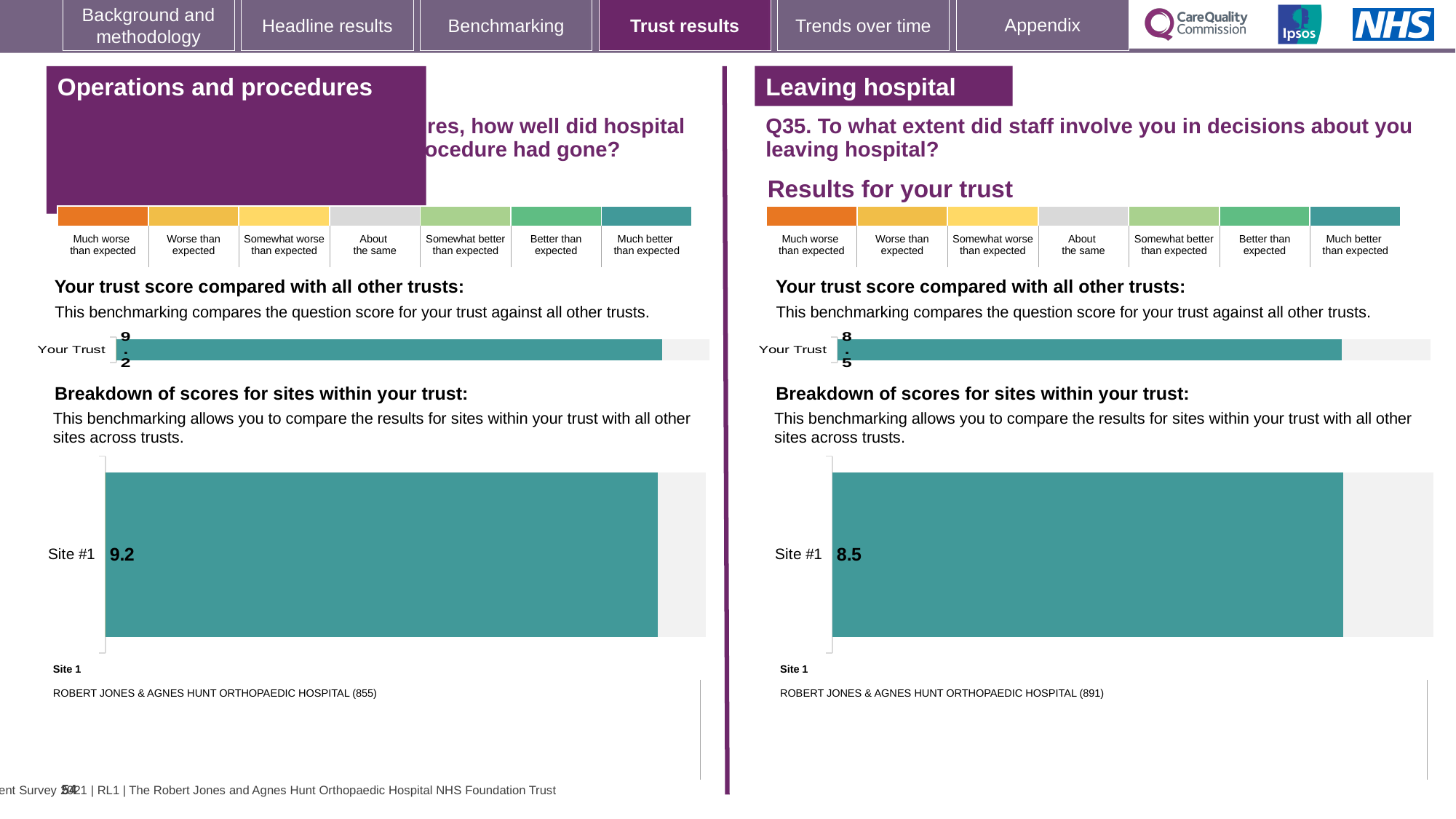
How many sites are shown in the site breakdown chart in the Leaving hospital section? 1 In the Leaving hospital section, what score is labelled on the Site #1 bar in the site breakdown chart? 8.5 Which section's Your Trust score is higher: Operations and procedures or Leaving hospital? Operations and procedures What is the difference between the Site #1 score in the Operations and procedures section and the Site #1 score in the Leaving hospital section? 0.7 What colour is the Site #1 bar in the Leaving hospital site breakdown chart? Teal In the Operations and procedures section, what is the score shown for Your Trust in the trust comparison bar chart? 9.2 In the Operations and procedures section, what score is labelled on the Site #1 bar in the site breakdown chart? 9.2 How many sites are shown in the site breakdown chart in the Operations and procedures section? 1 In the Leaving hospital section, what is the score shown for Your Trust in the trust comparison bar chart? 8.5 How many rating categories are shown in the colour key above the Leaving hospital trust comparison chart? 7 What type of chart is used to show the Site #1 score in the Leaving hospital section? Bar chart